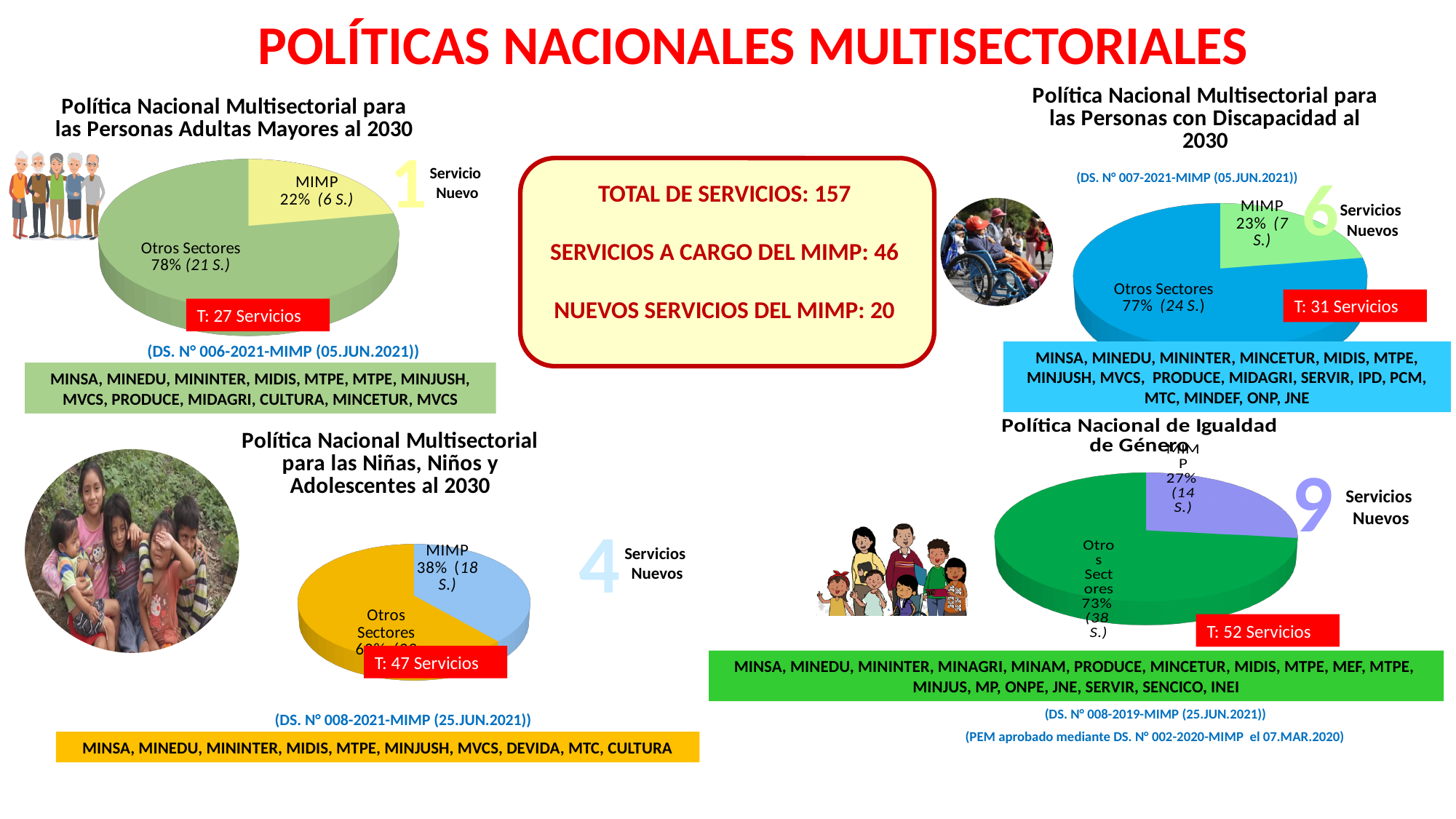
In the Personas Adultas Mayores al 2030 pie chart, how many services correspond to Otros Sectores? 21 S. In the Personas con Discapacidad al 2030 pie chart, what is the difference in number of services between Otros Sectores and MIMP? 17 How many slices does the Personas Adultas Mayores al 2030 pie chart have? 2 In the Igualdad de Género pie chart, how many services correspond to Otros Sectores? 38 S. In the Niñas, Niños y Adolescentes al 2030 pie chart, which slice is larger, MIMP or Otros Sectores? Otros Sectores In the Personas Adultas Mayores al 2030 pie chart, what share of services is attributed to MIMP? 22% What kind of chart is used for the Política Nacional Multisectorial para las Personas Adultas Mayores al 2030? Pie chart In the Personas con Discapacidad al 2030 pie chart, how many services correspond to MIMP? 7 S. In the Igualdad de Género pie chart, what share of services is attributed to MIMP? 27% In the Niñas, Niños y Adolescentes al 2030 pie chart, what share of services is attributed to MIMP? 38% How many pie charts are shown on the slide? 4